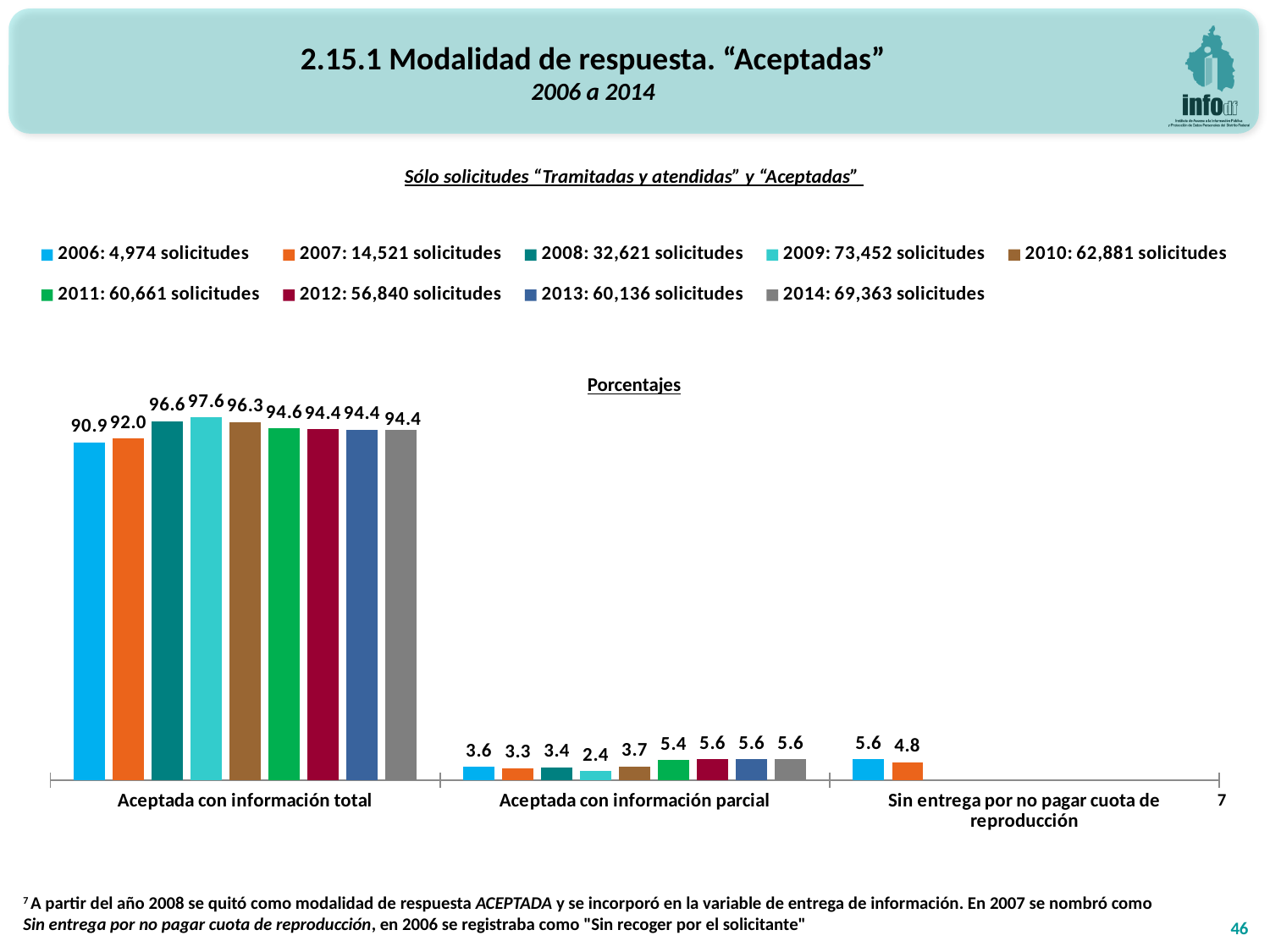
Which year has the highest value in the "Aceptada con información total" category? 2009 In the "Aceptada con información parcial" category, which is larger: the value for 2010 or the value for 2011? 2011 How many series does the legend list? 9 What is the difference between the 2006 and 2007 values in the "Sin entrega por no pagar cuota de reproducción" category? 0.8 What kind of chart is shown on the slide? Bar chart How many categories are shown on the x axis of the chart? 3 How many solicitudes does the legend give for 2009? 73,452 Which year has the lowest value in the "Aceptada con información parcial" category? 2009 What is the value for 2006 in the "Aceptada con información parcial" category? 3.6 What is the value for 2009 in the "Aceptada con información total" category? 97.6 What is the value for 2007 in the "Sin entrega por no pagar cuota de reproducción" category? 4.8 What is the difference between the 2009 and 2006 values in the "Aceptada con información total" category? 6.7